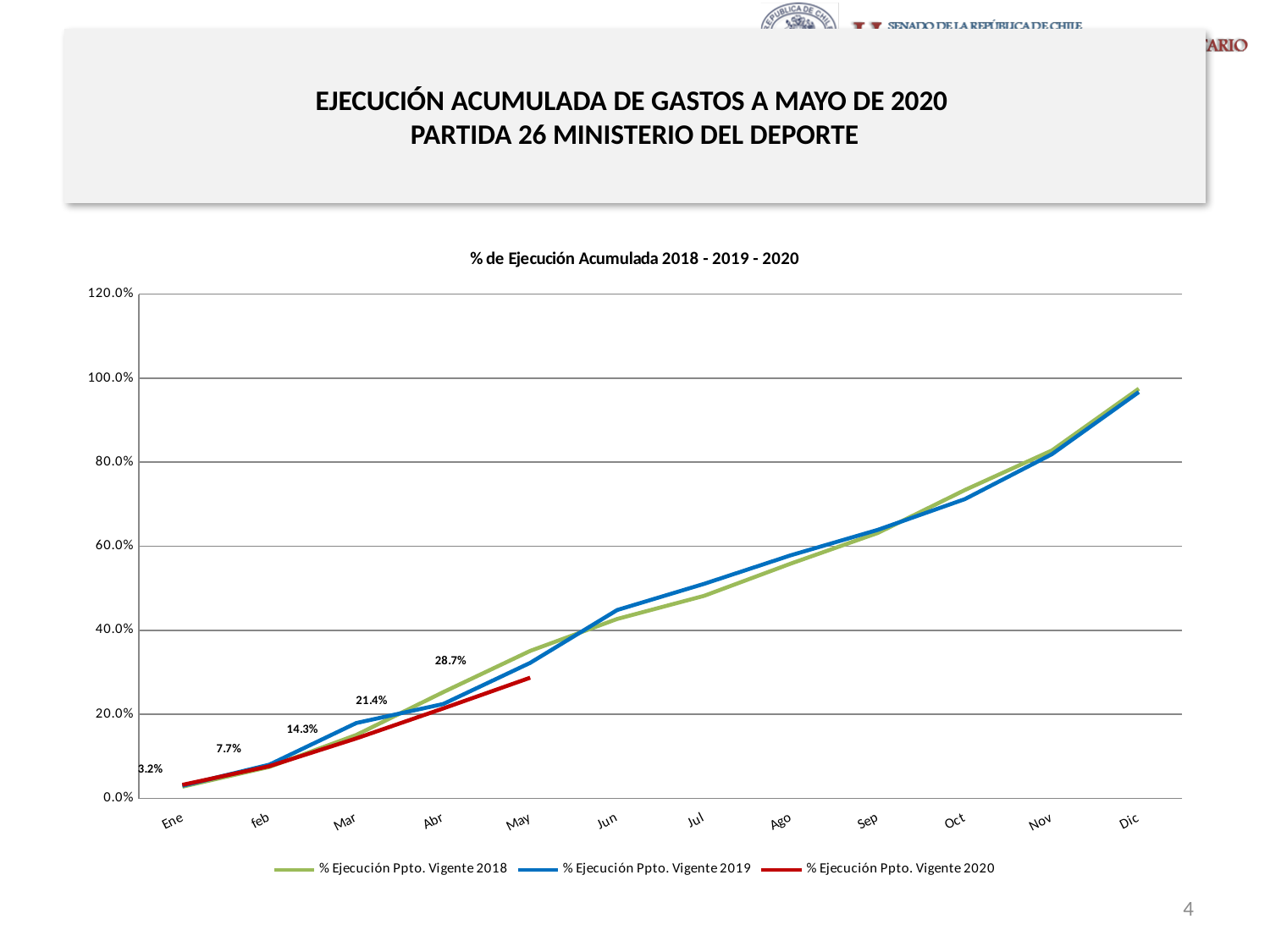
Is the value for % Ejecución Ppto. Vigente 2019 in Dic greater or less than 80.0%? greater How many series does the legend list? 3 In which month does the % Ejecución Ppto. Vigente 2020 series reach its highest value? May By how many percentage points did % Ejecución Ppto. Vigente 2020 increase from Abr to May? 7.3 percentage points What is the value of % Ejecución Ppto. Vigente 2020 for May? 28.7% What is the value of % Ejecución Ppto. Vigente 2020 for Ene? 3.2% By how many percentage points did % Ejecución Ppto. Vigente 2020 increase from feb to Mar? 6.6 percentage points What kind of chart is shown on the slide? Line chart What is the value of % Ejecución Ppto. Vigente 2020 for Abr? 21.4% How many months are shown on the x axis? 12 What is the value of % Ejecución Ppto. Vigente 2020 for Mar? 14.3% Do the values of % Ejecución Ppto. Vigente 2018 rise or fall from Ene to Dic? rise